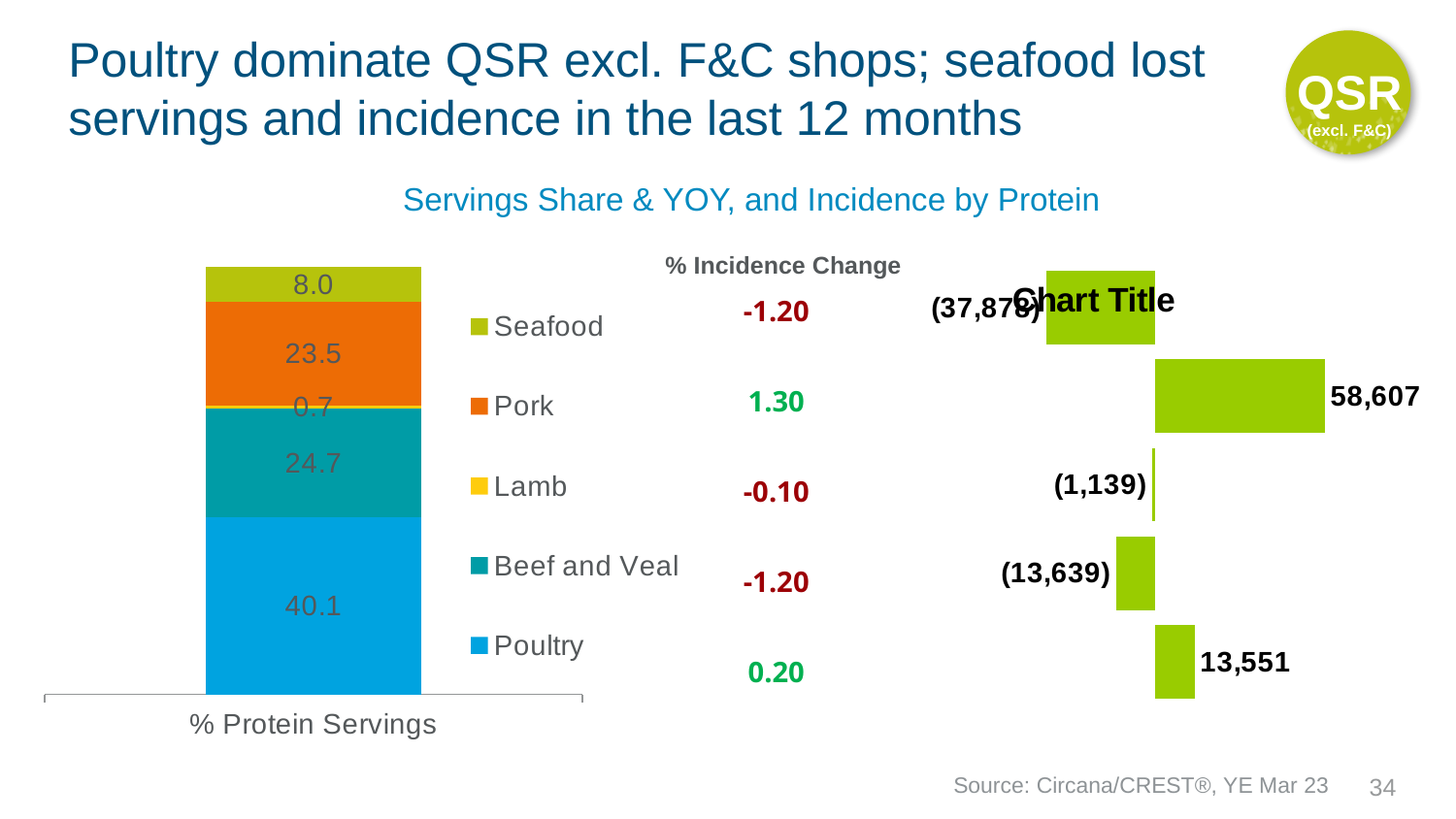
In the % Protein Servings chart, what is the value for Pork? 23.5 In the % Protein Servings chart, what is the value for Poultry? 40.1 In the % Protein Servings chart, which protein has the largest share of servings? Poultry In the % Protein Servings chart, which is larger, Pork or Beef and Veal? Beef and Veal In the % Protein Servings chart, what is the difference between the Poultry and Beef and Veal values? 15.4 In the chart on the right labelled Chart Title, what is the value for the Pork bar? 58,607 How many series does the legend of the % Protein Servings chart list? 5 What is the total of the stacked bar in the % Protein Servings chart? 97.0 In the % Protein Servings chart, what is the value for Seafood? 8.0 In the chart on the right labelled Chart Title, what is the value for the Poultry bar? 13,551 What type of chart is the % Protein Servings chart? Stacked bar chart In the % Protein Servings chart, which protein has the smallest share of servings? Lamb